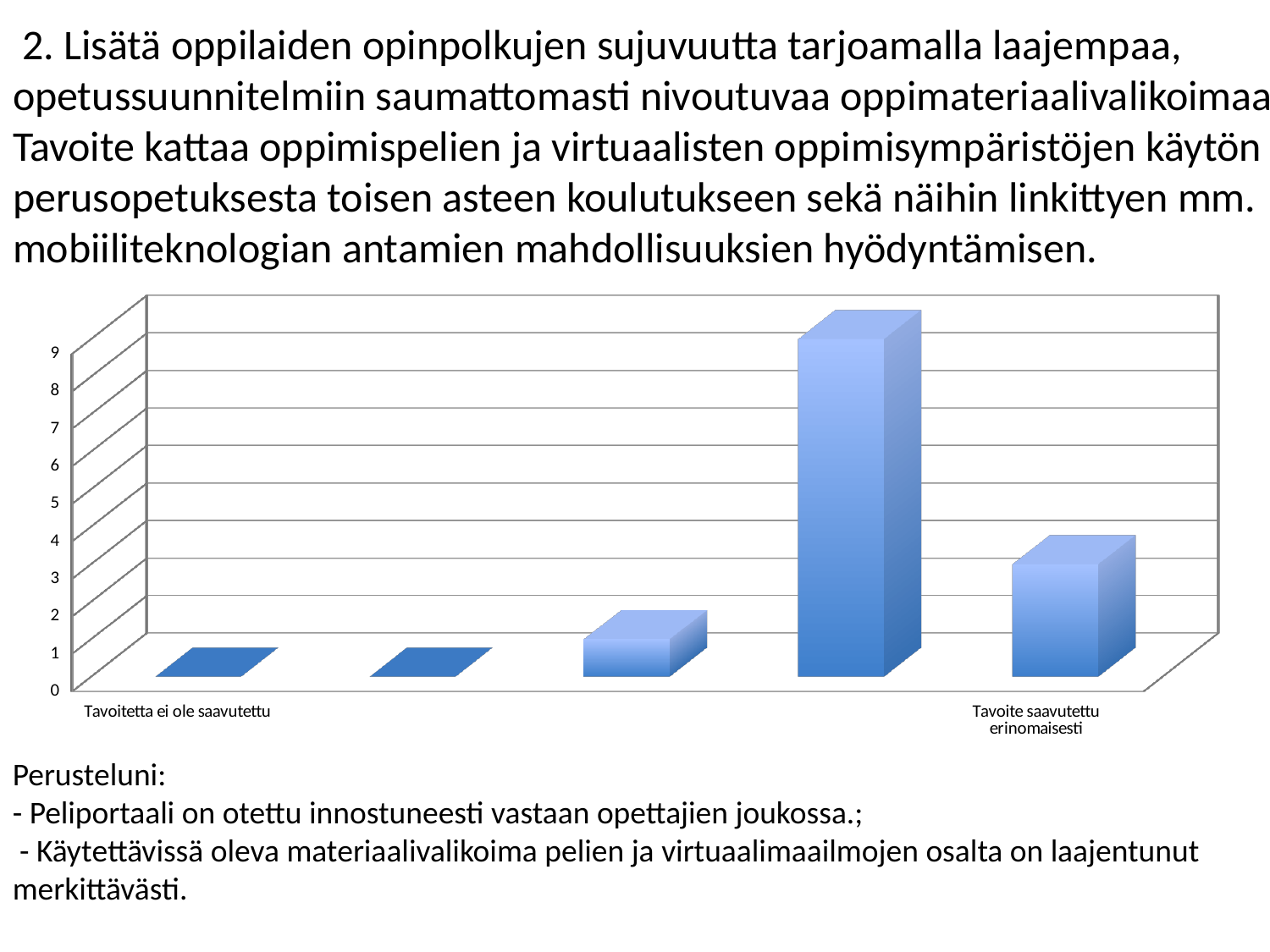
Is the value for Tavoite saavutettu erinomaisesti greater or less than 2? greater What kind of chart is shown on the slide? bar chart How many bars does the chart show? 5 Is the value for Tavoite saavutettu erinomaisesti greater or less than 5? less Is the tallest bar in the chart the one labelled Tavoite saavutettu erinomaisesti? No Is the value for Tavoitetta ei ole saavutettu greater or less than 1? less Which is larger, the value for Tavoitetta ei ole saavutettu or the value for Tavoite saavutettu erinomaisesti? Tavoite saavutettu erinomaisesti What is the highest tick value shown on the vertical axis? 9